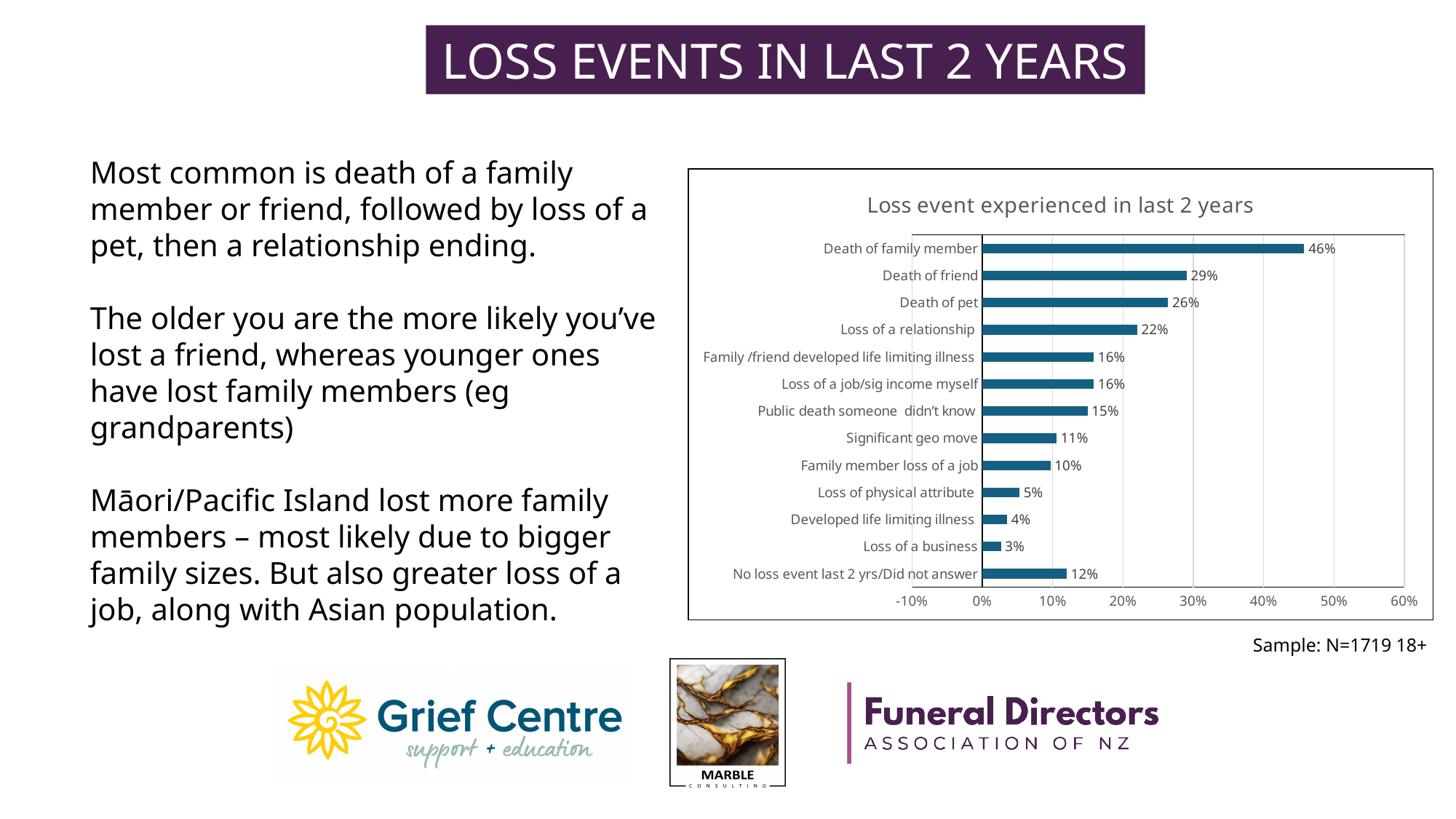
Which category has the lowest value? Loss of a business What is the title of the chart? Loss event experienced in last 2 years What is the difference between Death of family member and Death of friend? 17% How many categories are shown in the chart? 13 Which category has the highest value? Death of family member What is the difference between Death of pet and Significant geo move? 15% What is the value for Death of family member? 46% What kind of chart is shown? Bar chart Which is larger, Family member loss of a job or Loss of physical attribute? Family member loss of a job Which is larger, Death of pet or Loss of a relationship? Death of pet What is the value for Loss of a relationship? 22% What is the value for No loss event last 2 yrs/Did not answer? 12%